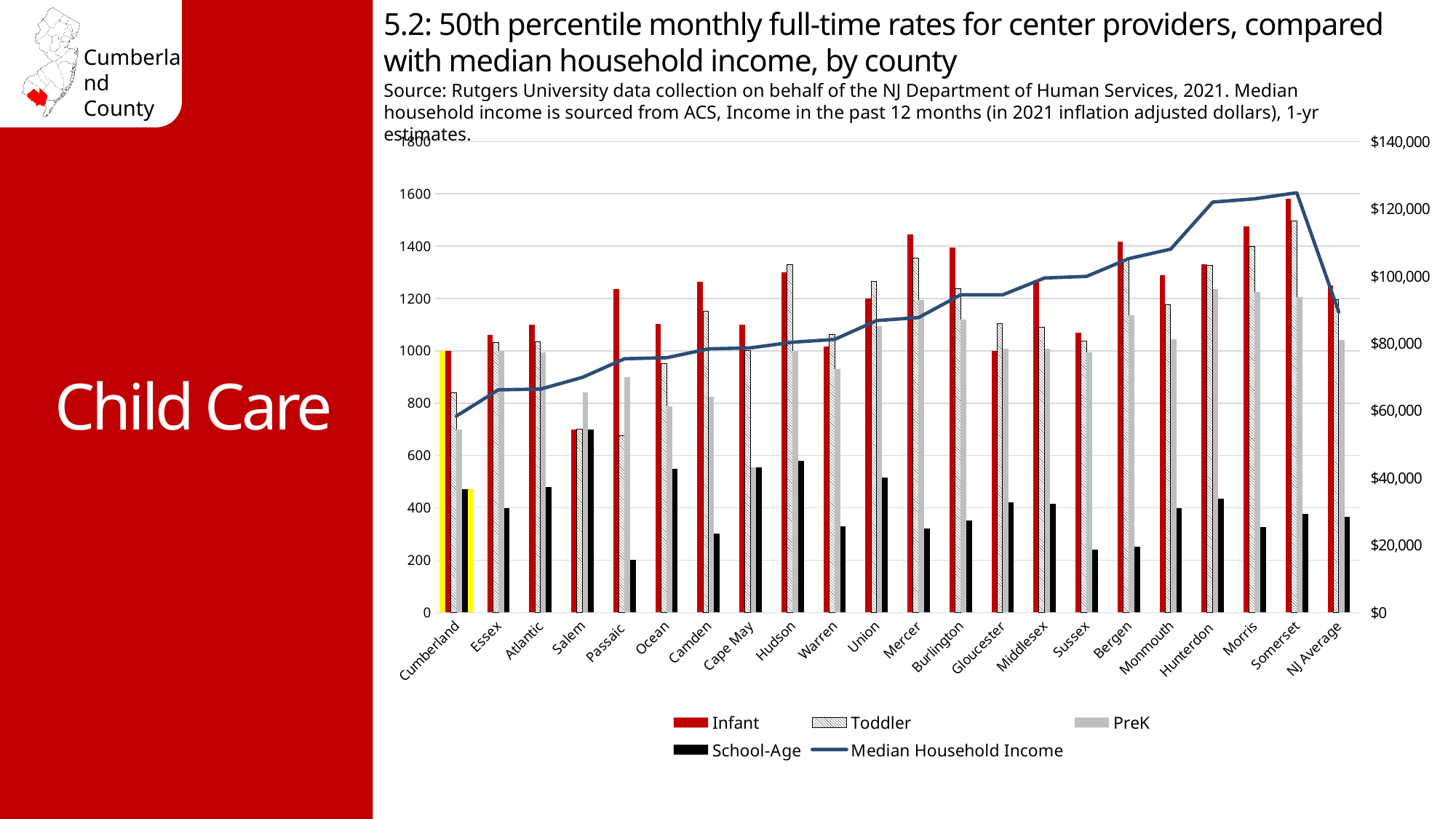
How many categories are shown on the x axis of the chart? 22 Is the Infant rate for Somerset greater or less than 1400? greater Which is larger, the Infant rate for Somerset or the Infant rate for Cumberland? Somerset Which county has the lowest Median Household Income on the chart? Cumberland Which category has the lowest Infant rate? Salem How many series does the legend list? 5 Is the Median Household Income for Cumberland greater or less than $80,000? less Does the Median Household Income line generally rise or fall from Cumberland to Somerset along the x axis? rise Which category has the highest School-Age rate? Salem Is the School-Age rate for Cumberland greater or less than 600? less Which category has the highest Infant rate? Somerset Which category has the lowest School-Age rate? Passaic